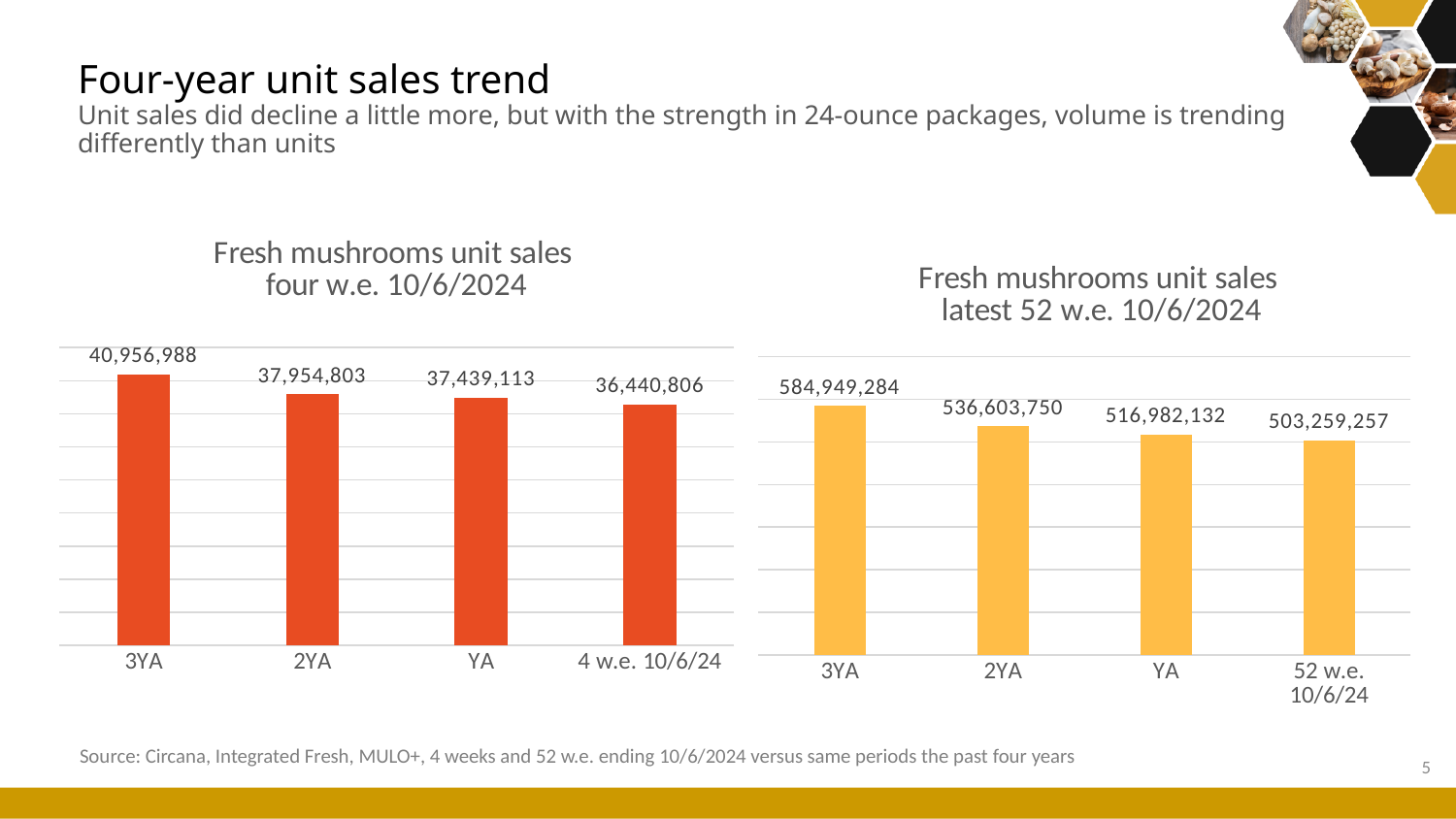
In the 'Fresh mushrooms unit sales four w.e. 10/6/2024' chart, which category has the highest value? 3YA In the 'Fresh mushrooms unit sales latest 52 w.e. 10/6/2024' chart, what is the difference between the 2YA and YA values? 19,621,618 What kind of chart is the 'Fresh mushrooms unit sales latest 52 w.e. 10/6/2024' chart? Bar chart In the 'Fresh mushrooms unit sales latest 52 w.e. 10/6/2024' chart, which is larger, the value for 3YA or the value for 2YA? 3YA How many categories are shown in the 'Fresh mushrooms unit sales four w.e. 10/6/2024' chart? 4 In the 'Fresh mushrooms unit sales four w.e. 10/6/2024' chart, what is the value for 3YA? 40,956,988 In the 'Fresh mushrooms unit sales latest 52 w.e. 10/6/2024' chart, which category has the lowest value? 52 w.e. 10/6/24 In the 'Fresh mushrooms unit sales four w.e. 10/6/2024' chart, what is the value for 4 w.e. 10/6/24? 36,440,806 In the 'Fresh mushrooms unit sales latest 52 w.e. 10/6/2024' chart, what is the value for 52 w.e. 10/6/24? 503,259,257 In the 'Fresh mushrooms unit sales latest 52 w.e. 10/6/2024' chart, do the values rise or fall from 3YA to 52 w.e. 10/6/24? Fall In the 'Fresh mushrooms unit sales four w.e. 10/6/2024' chart, what is the difference between the 3YA and 2YA values? 3,002,185 In the 'Fresh mushrooms unit sales latest 52 w.e. 10/6/2024' chart, what is the value for YA? 516,982,132